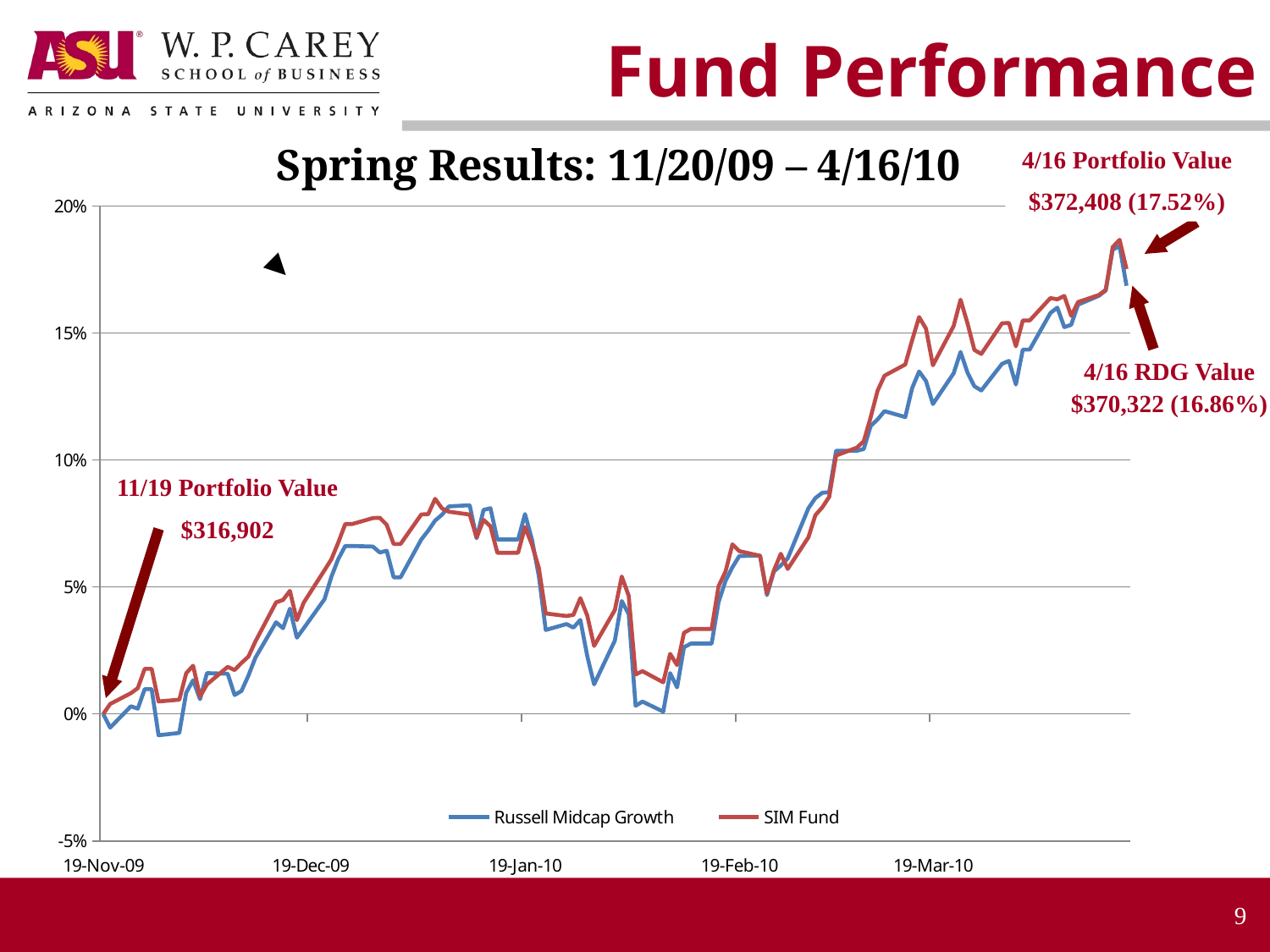
Is the SIM Fund value at 19-Mar-10 greater or less than 10%? greater According to the annotations, which is larger on 4/16: the Portfolio Value or the RDG Value? Portfolio Value What is the 4/16 RDG Value annotated on the chart? $370,322 (16.86%) What is the title of the chart? Spring Results: 11/20/09 – 4/16/10 Overall, do the plotted values rise or fall from 19-Nov-09 to the end of the period? rise What is the difference between the 4/16 Portfolio Value and the 4/16 RDG Value in dollars? $2,086 What is the 11/19 Portfolio Value annotated on the chart? $316,902 Is the Russell Midcap Growth value at 19-Jan-10 greater or less than 10%? less What kind of chart is shown on the slide? line chart What is the 4/16 Portfolio Value annotated on the chart? $372,408 (17.52%) How many series does the chart legend list? 2 What are the two series named in the chart legend? Russell Midcap Growth and SIM Fund